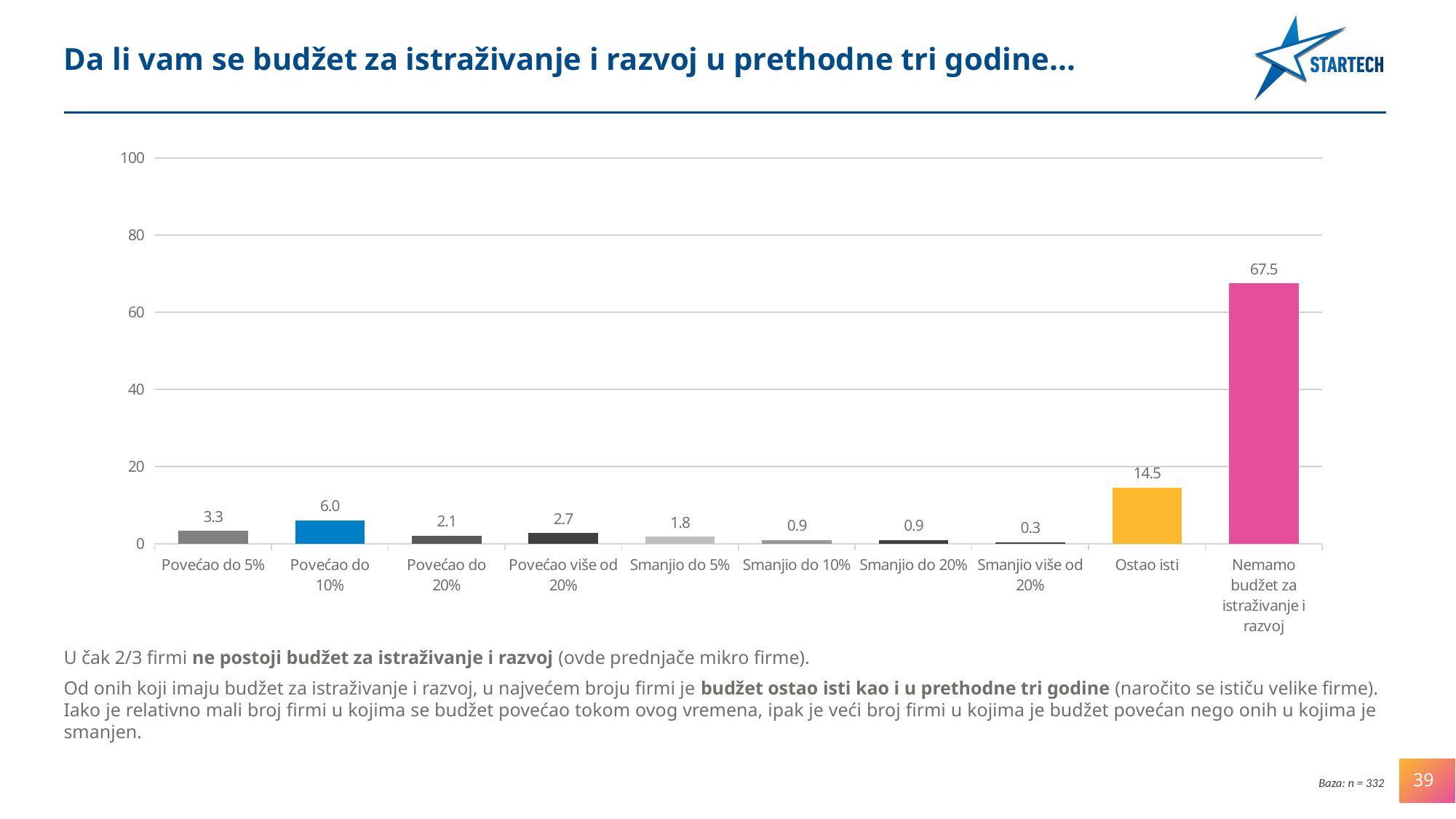
Which category has the lowest value? Smanjio više od 20% How many categories are shown on the x axis? 10 Which category has the highest value? Nemamo budžet za istraživanje i razvoj What is the value for "Smanjio više od 20%"? 0.3 What is the value for "Povećao do 10%"? 6.0 What is the difference between the values for "Nemamo budžet za istraživanje i razvoj" and "Ostao isti"? 53.0 What is the sample size (Baza) stated on the slide? n = 332 Which is larger, the value for "Povećao do 5%" or the value for "Povećao do 20%"? Povećao do 5% What is the value for "Ostao isti"? 14.5 Is the value for "Nemamo budžet za istraživanje i razvoj" greater or less than 60? greater What kind of chart is shown on the slide? bar chart What is the value for "Nemamo budžet za istraživanje i razvoj"? 67.5